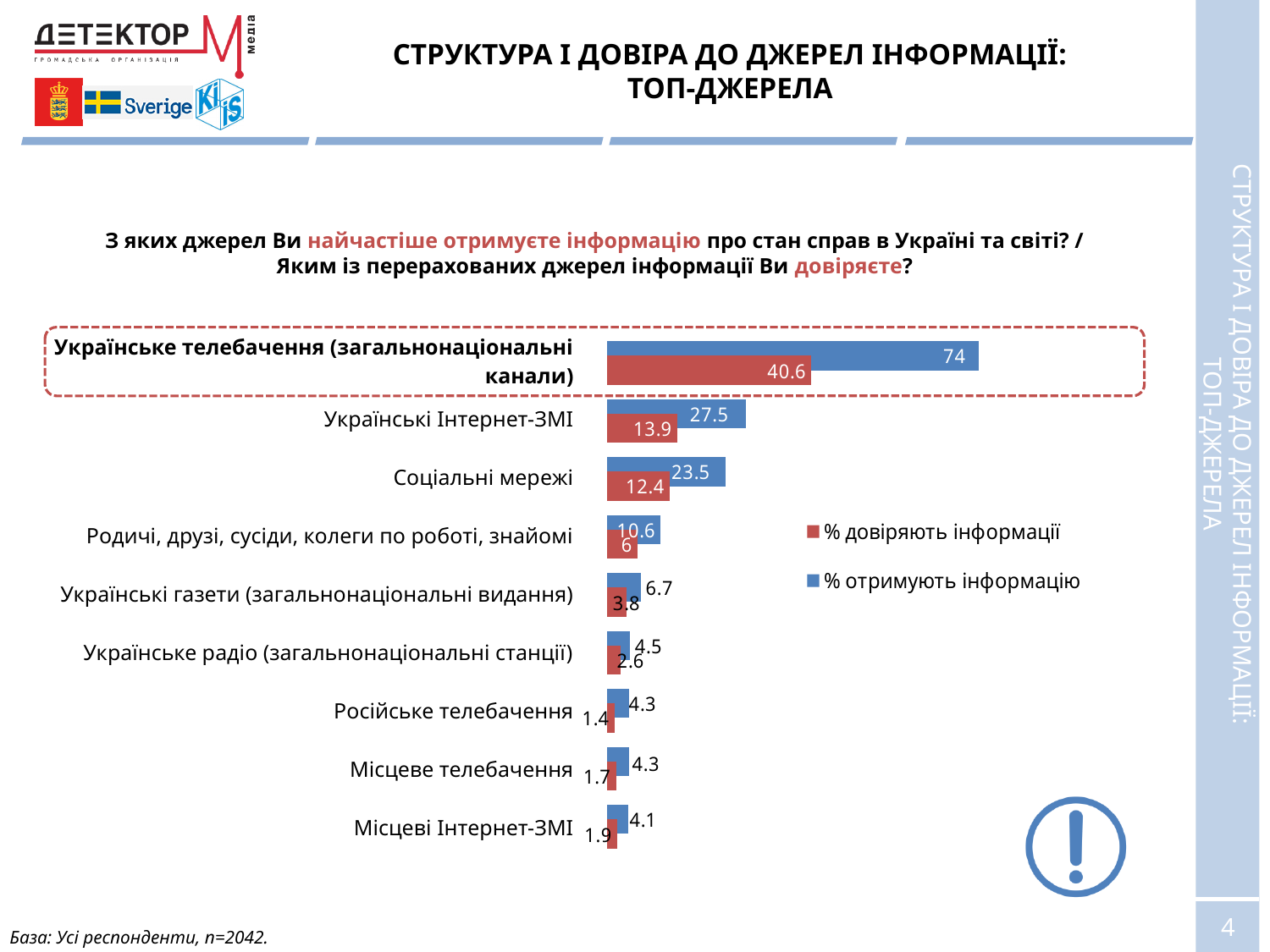
Which category has the lowest value of "% довіряють інформації"? Російське телебачення What is the value of "% отримують інформацію" for "Українське телебачення (загальнонаціональні канали)"? 74 What is the value of "% довіряють інформації" for "Соціальні мережі"? 12.4 What is the value of "% отримують інформацію" for "Українські Інтернет-ЗМІ"? 27.5 Which category has the highest value of "% отримують інформацію"? Українське телебачення (загальнонаціональні канали) Which is larger: "% отримують інформацію" for "Соціальні мережі" or for "Родичі, друзі, сусіди, колеги по роботі, знайомі"? Соціальні мережі Which colour represents the series "% довіряють інформації" in the chart? red What type of chart is shown on the slide? bar chart What is the difference between "% отримують інформацію" and "% довіряють інформації" for "Українське телебачення (загальнонаціональні канали)"? 33.4 How many series does the legend list? 2 How many information sources (categories) are shown in the chart? 9 What is the value of "% довіряють інформації" for "Українське телебачення (загальнонаціональні канали)"? 40.6